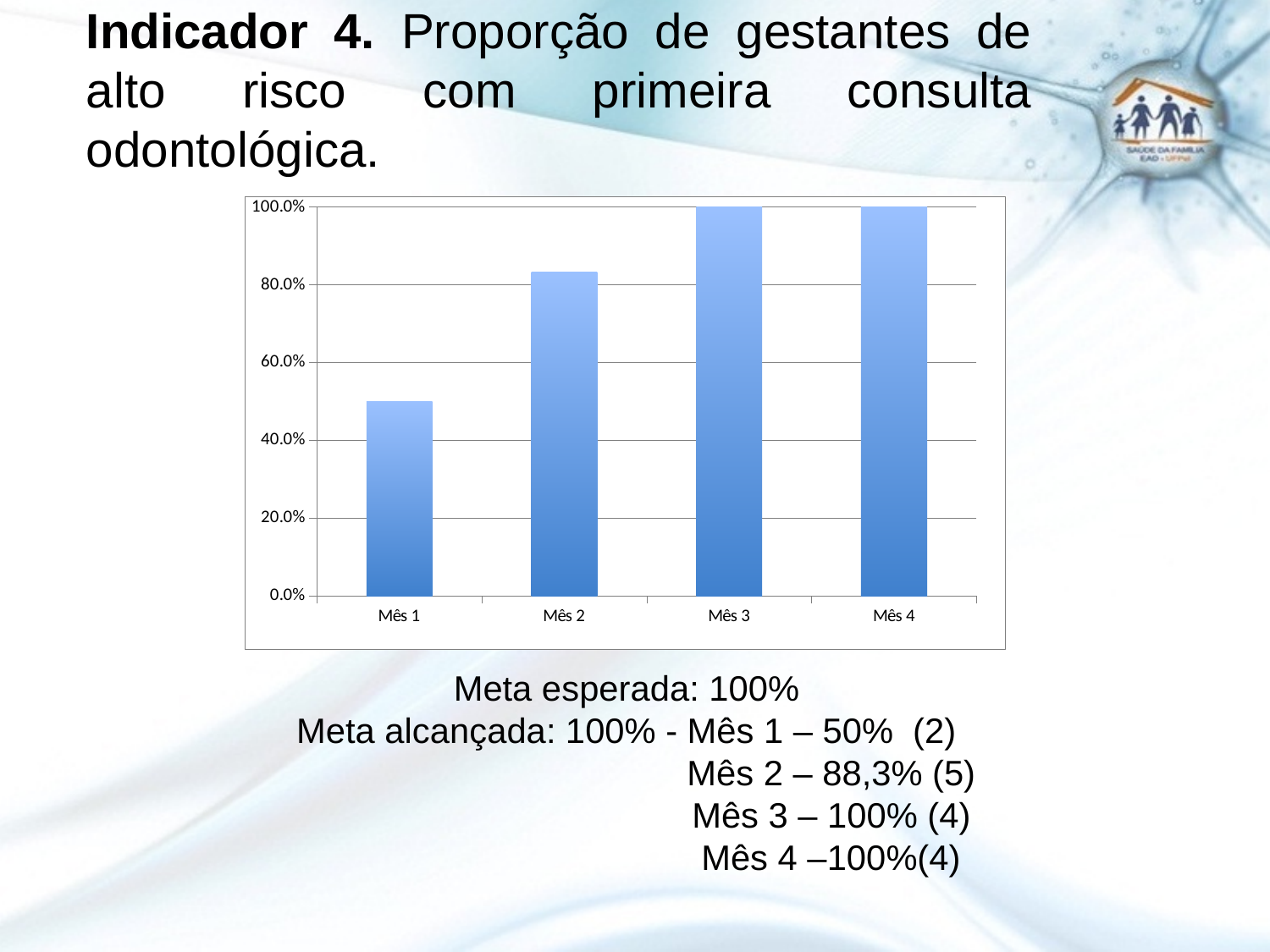
Is the value for Mês 1 greater or less than 40.0%? greater What kind of chart is shown on the slide? bar chart What is the difference between the values for Mês 3 and Mês 4? 0.0% What is the highest tick value shown on the y axis? 100.0% What is the value for Mês 4? 100.0% Which is larger, the value for Mês 1 or the value for Mês 2? Mês 2 Is the value for Mês 2 greater or less than 80.0%? greater What is the value for Mês 3? 100.0% Which month has the lowest value in the chart? Mês 1 How many categories (months) are plotted on the x axis? 4 Is the value for Mês 1 greater or less than 60.0%? less Do the values rise or fall from Mês 1 to Mês 4? rise